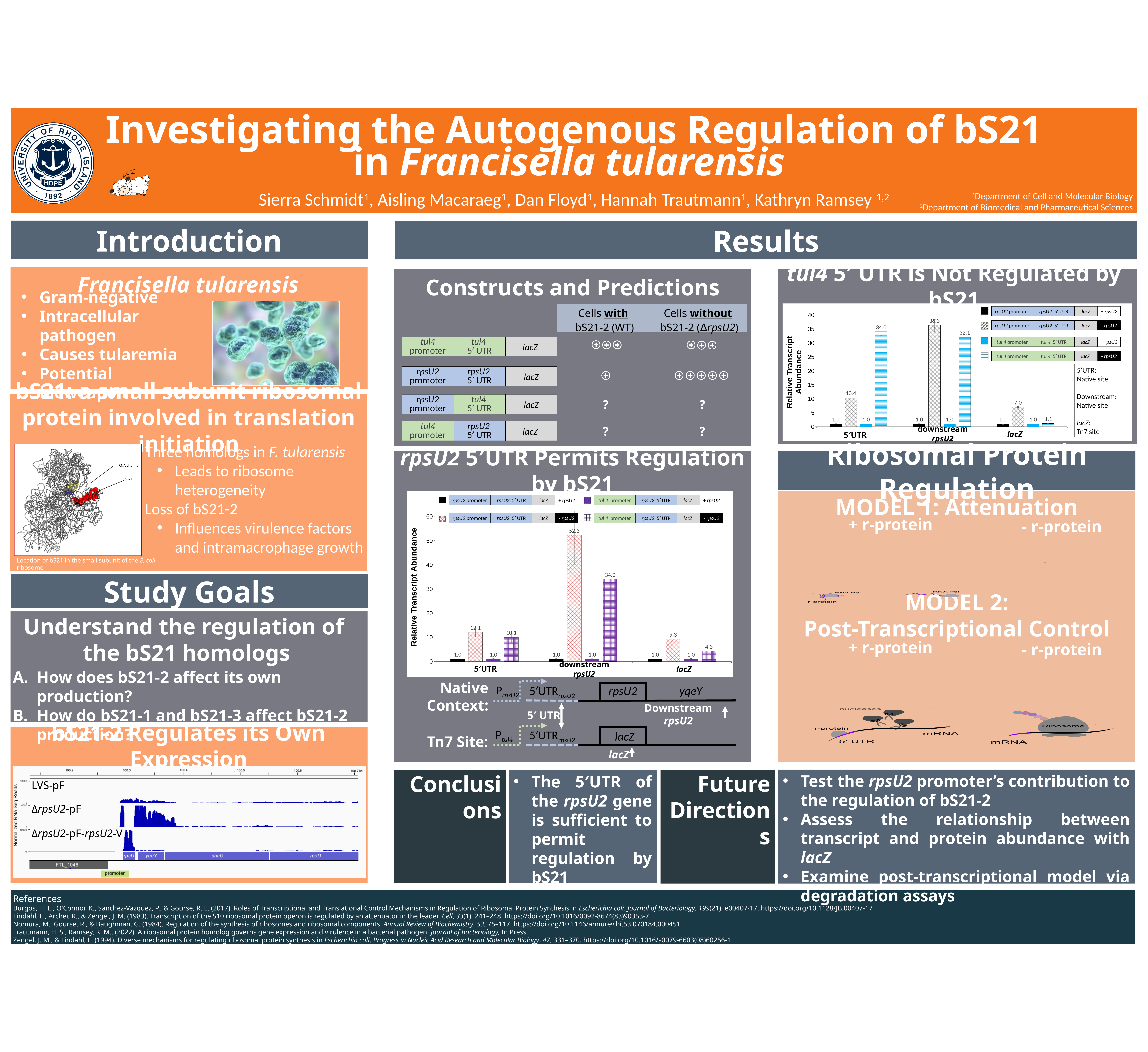
What type of chart is the 'rpsU2 5'UTR Permits Regulation by bS21' chart? bar chart In the 'rpsU2 5'UTR Permits Regulation by bS21' chart, which is larger in the lacZ group: the pink hatched bar or the purple grid-patterned bar? the pink hatched bar (9.3) In the 'tul4 5' UTR is Not Regulated by bS21' chart, what is the value of the hatched rpsU2 promoter -rpsU2 bar in the lacZ group? 7.0 In the 'rpsU2 5'UTR Permits Regulation by bS21' chart, what is the difference between the pink hatched bar (52.3) and the purple grid-patterned bar (34.0) in the downstream rpsU2 group? 18.3 In the 'tul4 5' UTR is Not Regulated by bS21' chart, how many category groups are on the x axis? 3 In the 'tul4 5' UTR is Not Regulated by bS21' chart, how many series does the legend list? 4 In the 'rpsU2 5'UTR Permits Regulation by bS21' chart, what is the highest data label shown? 52.3 In the 'tul4 5' UTR is Not Regulated by bS21' chart, what is the highest data label shown? 36.3 In the 'tul4 5' UTR is Not Regulated by bS21' chart, what is the value of the tallest bar in the 5'UTR group? 34.0 In the 'rpsU2 5'UTR Permits Regulation by bS21' chart, what is the value of the purple grid-patterned bar in the downstream rpsU2 group? 34.0 In the 'tul4 5' UTR is Not Regulated by bS21' chart, what is the difference between the two tallest bars in the downstream rpsU2 group (36.3 and 32.1)? 4.2 In the 'rpsU2 5'UTR Permits Regulation by bS21' chart, what is the value of the pink hatched bar in the 5'UTR group? 12.1